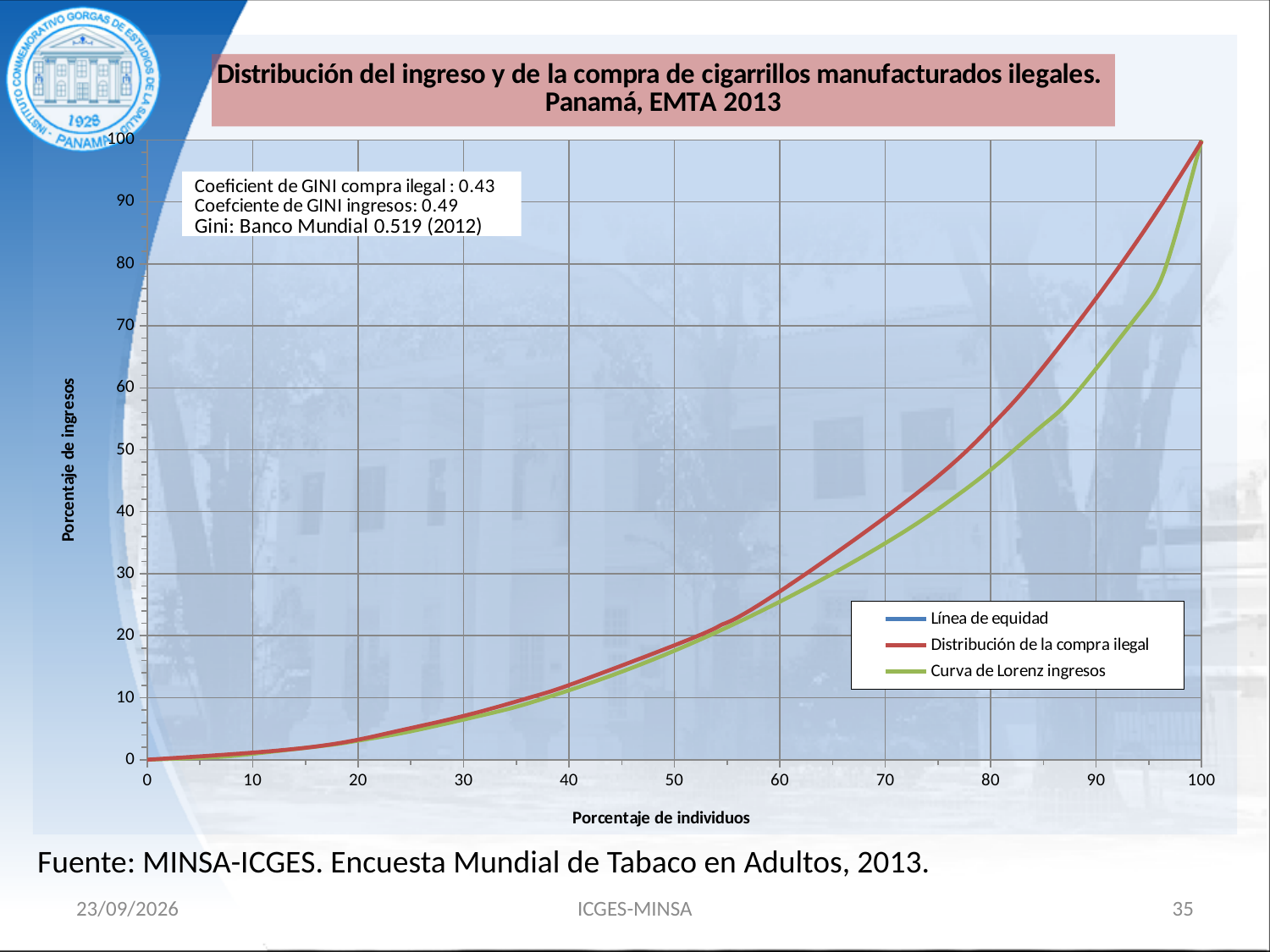
What kind of chart is shown on the slide? Line chart At 90% of individuals, is the value of 'Distribución de la compra ilegal' greater or less than 70? greater Which series is drawn in green in the legend? Curva de Lorenz ingresos What value do both curves reach at 100% of individuals? 100 What is the title of the chart? Distribución del ingreso y de la compra de cigarrillos manufacturados ilegales. Panamá, EMTA 2013 At 80% of individuals, is the value of 'Curva de Lorenz ingresos' greater or less than 50? less At 80% of individuals, is the value of 'Distribución de la compra ilegal' greater or less than 50? greater At 80% of individuals, which curve is higher: 'Distribución de la compra ilegal' or 'Curva de Lorenz ingresos'? Distribución de la compra ilegal Do the values of the 'Distribución de la compra ilegal' curve rise or fall as the percentage of individuals increases? Rise How many series does the legend list? 3